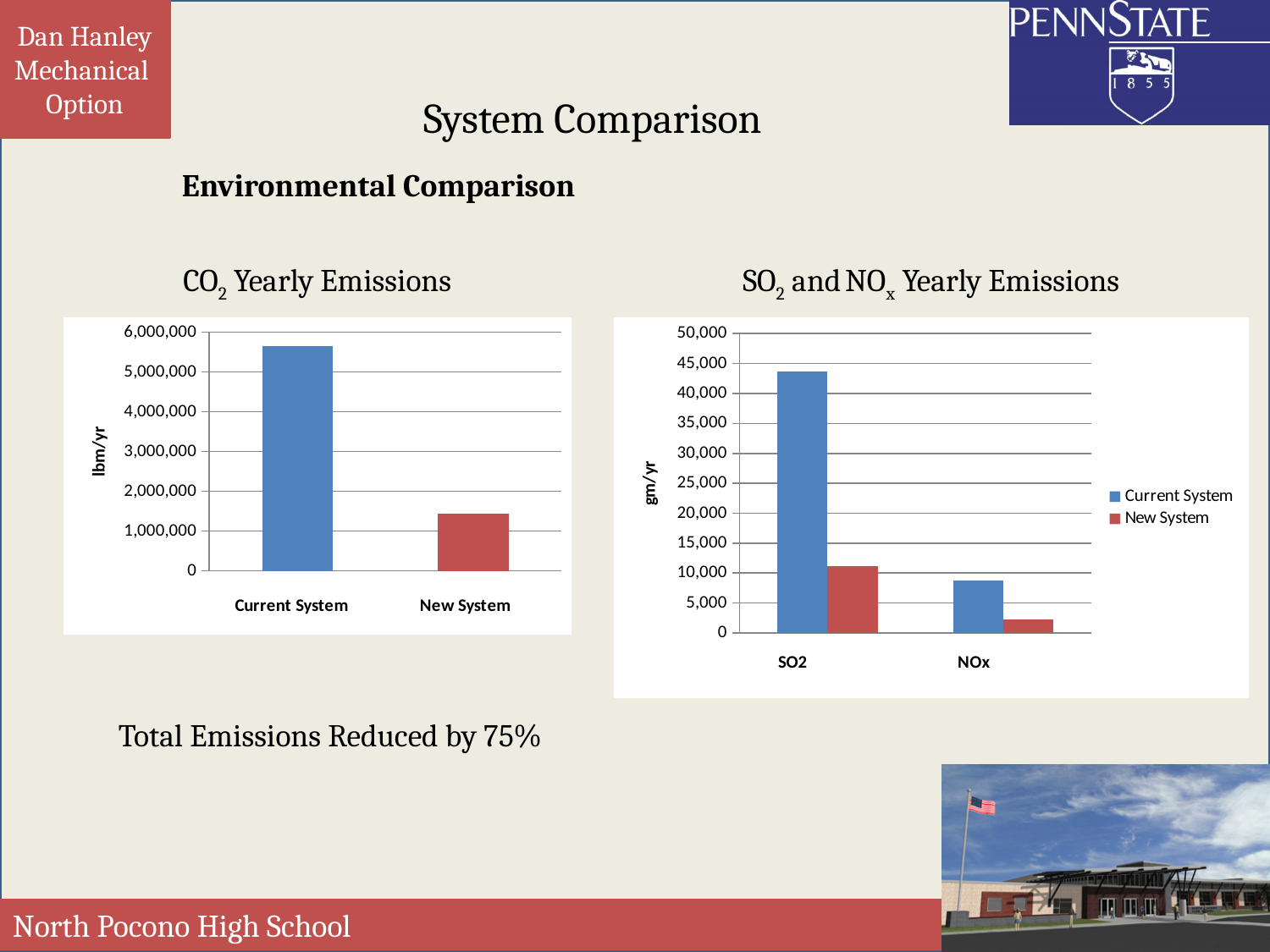
In the SO2 and NOx Yearly Emissions chart, which is larger: the Current System value for NOx or the New System value for SO2? New System value for SO2 In the SO2 and NOx Yearly Emissions chart, which bar is the lowest? New System for NOx In the SO2 and NOx Yearly Emissions chart, is the Current System value for NOx greater or less than 10,000? less How many categories are shown on the x axis of the CO2 Yearly Emissions chart? 2 What is the y-axis unit label on the CO2 Yearly Emissions chart? lbm/yr In the SO2 and NOx Yearly Emissions chart, is the Current System value for SO2 greater or less than 40,000? greater In the SO2 and NOx Yearly Emissions chart, is the New System value for SO2 greater or less than 15,000? less What kind of chart is the CO2 Yearly Emissions chart? bar chart In the SO2 and NOx Yearly Emissions chart, how many series does the legend list? 2 In the CO2 Yearly Emissions chart, which system has the higher emissions? Current System